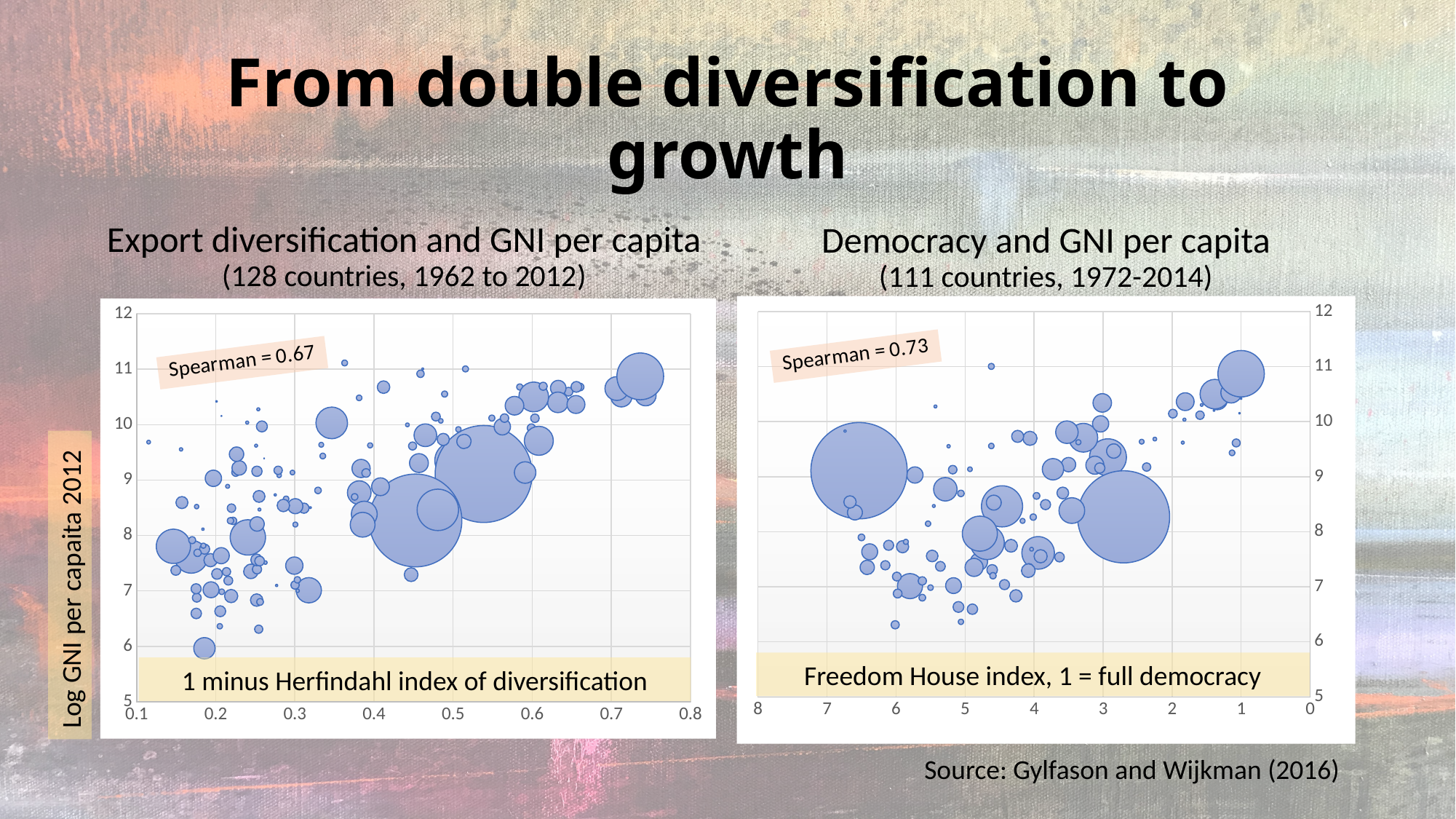
What is the x-axis label of the 'Export diversification and GNI per capita' chart? 1 minus Herfindahl index of diversification In the 'Export diversification and GNI per capita' chart, what Spearman correlation is shown? 0.67 What kind of chart is the 'Export diversification and GNI per capita' chart? Bubble chart In the 'Export diversification and GNI per capita' chart, do the bubbles generally rise or fall as the x-axis value increases from 0.1 to 0.8? Rise How many countries are included in the 'Democracy and GNI per capita' chart, according to its subtitle? 111 countries In the 'Democracy and GNI per capita' chart, what Spearman correlation is shown? 0.73 What is the difference between the Spearman correlations shown in the 'Democracy and GNI per capita' chart and the 'Export diversification and GNI per capita' chart? 0.06 What is the x-axis label of the 'Democracy and GNI per capita' chart? Freedom House index, 1 = full democracy Which chart shows the higher Spearman correlation, 'Export diversification and GNI per capita' or 'Democracy and GNI per capita'? Democracy and GNI per capita What kind of chart is the 'Democracy and GNI per capita' chart? Bubble chart How many countries are included in the 'Export diversification and GNI per capita' chart, according to its subtitle? 128 countries In the 'Democracy and GNI per capita' chart, do the bubbles generally rise or fall moving from left to right along the x axis (from 8 toward 0)? Rise